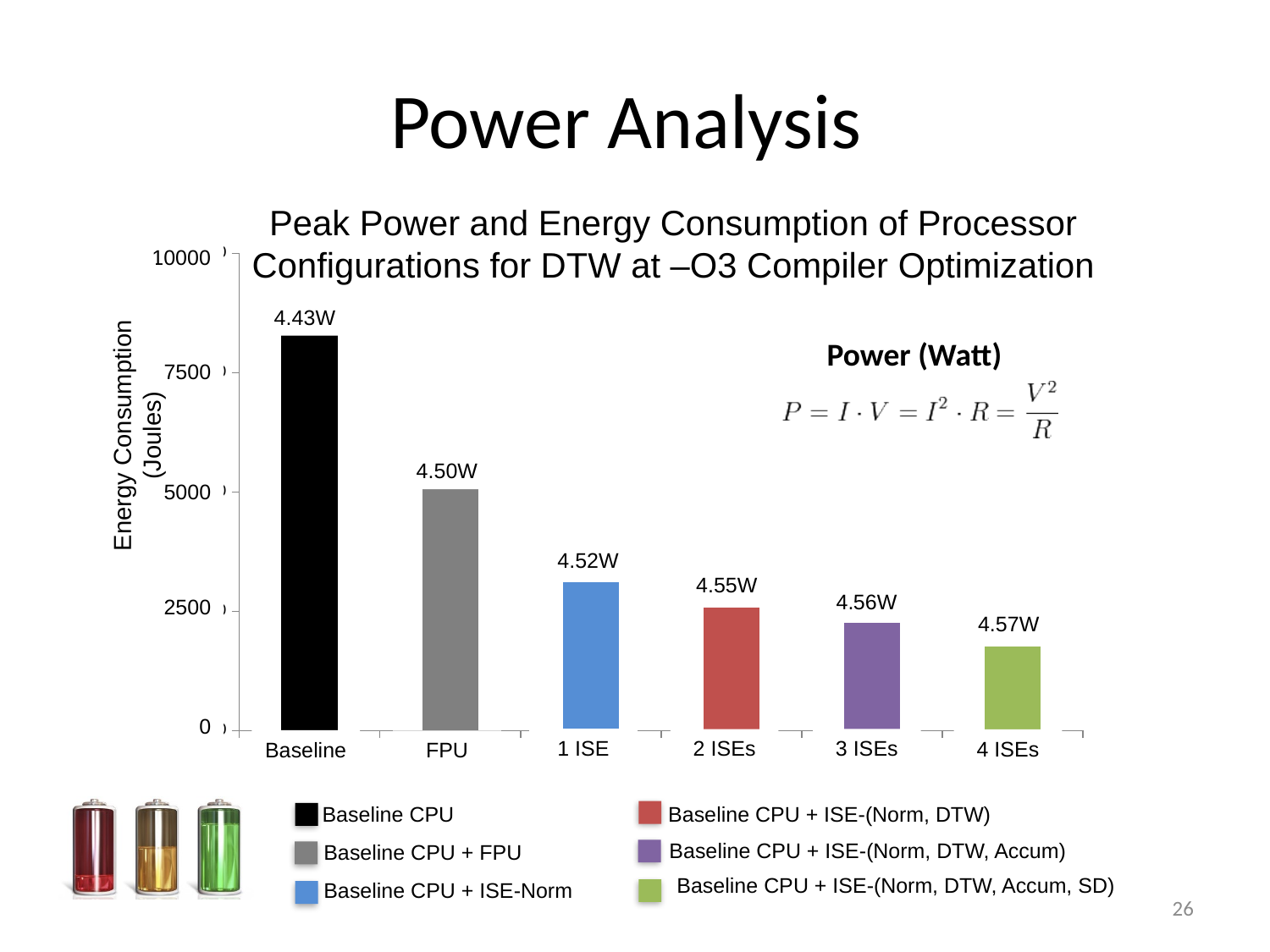
Which configuration has the lowest energy consumption? 4 ISEs What is the difference between the peak power labels of the 4 ISEs bar and the Baseline bar? 0.14W What peak power label is shown above the 2 ISEs bar? 4.55W How many entries does the legend below the chart list? 6 What peak power label is shown above the 4 ISEs bar? 4.57W What peak power label is shown above the Baseline bar? 4.43W Is the energy consumption for Baseline greater or less than 7500 Joules? greater Does energy consumption rise or fall moving from Baseline to 4 ISEs along the x axis? fall Is the energy consumption for 4 ISEs greater or less than 2500 Joules? less How many processor configurations (bars) are plotted in the chart? 6 What kind of chart is shown on the slide? bar chart Which configuration has the highest energy consumption? Baseline